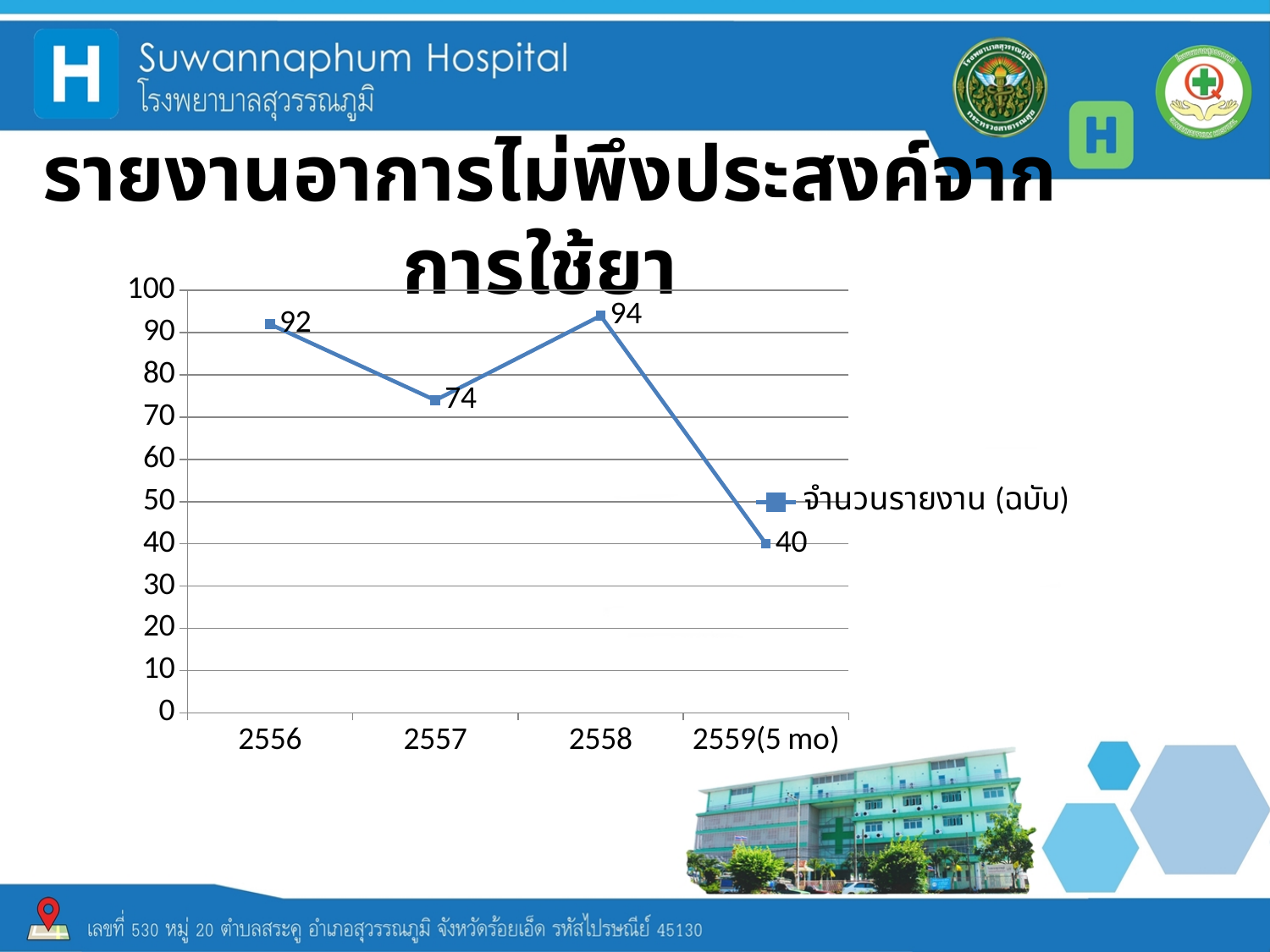
What is the value for 2559(5 mo)? 40 What is the difference between the values for 2558 and 2557? 20 How many categories are shown on the x axis? 4 Which is larger, the value for 2556 or the value for 2557? 2556 What kind of chart is shown on the slide? line chart What is the value for 2556? 92 Which category has the highest value? 2558 What is the value for 2558? 94 Which category has the lowest value? 2559(5 mo) What is the value for 2557? 74 What is the difference between the values for 2556 and 2559(5 mo)? 52 What is the legend entry for the plotted series? จำนวนรายงาน (ฉบับ)